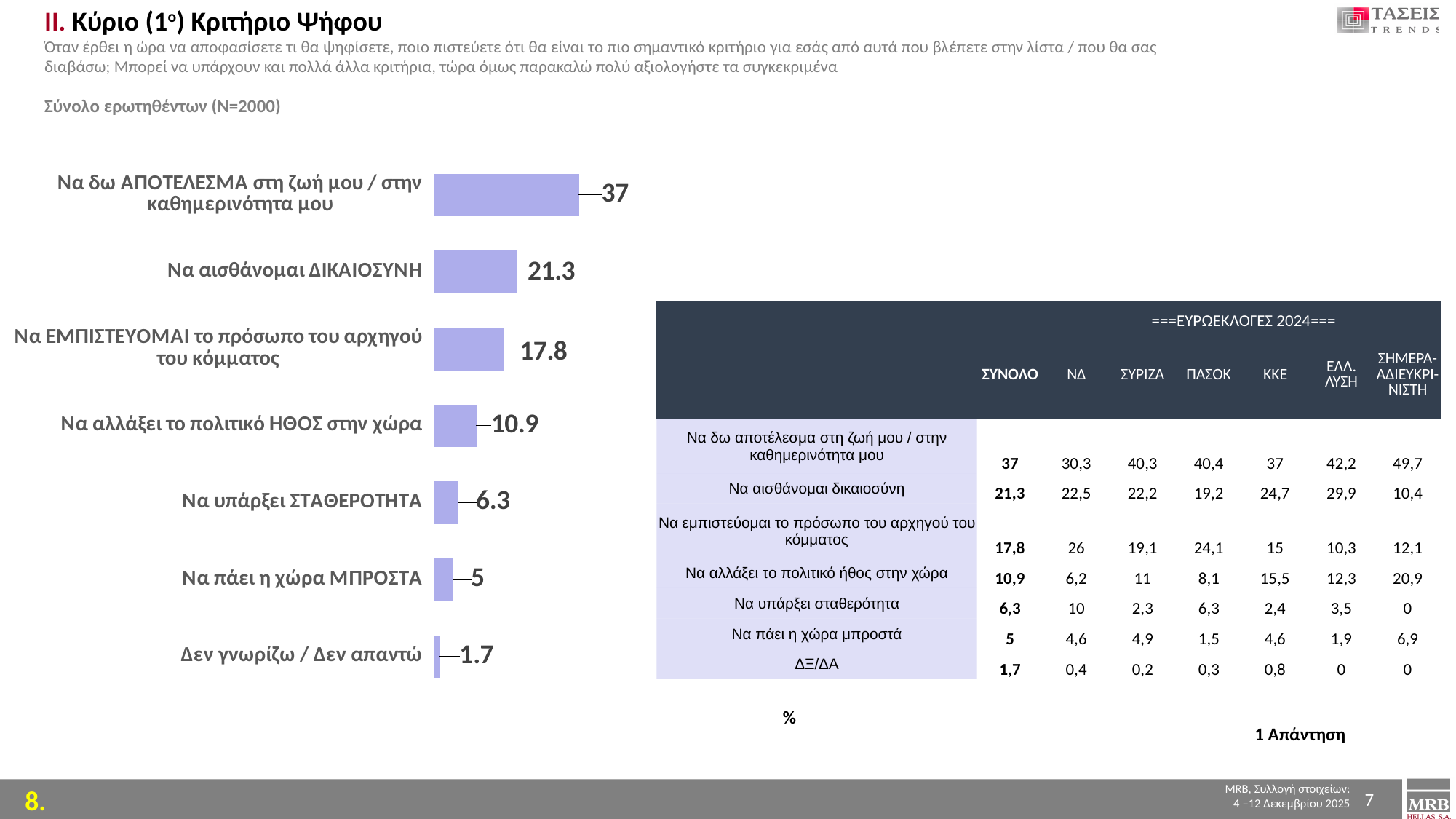
How many categories are shown in the bar chart? 7 What is the value for "Να δω ΑΠΟΤΕΛΕΣΜΑ στη ζωή μου / στην καθημερινότητα μου" in the bar chart? 37 Which category has the highest value in the bar chart? Να δω ΑΠΟΤΕΛΕΣΜΑ στη ζωή μου / στην καθημερινότητα μου What is the value for "Να αισθάνομαι ΔΙΚΑΙΟΣΥΝΗ" in the bar chart? 21.3 Which category has the lowest value in the bar chart? Δεν γνωρίζω / Δεν απαντώ What is the value for "Να ΕΜΠΙΣΤΕΥΟΜΑΙ το πρόσωπο του αρχηγού του κόμματος" in the bar chart? 17.8 What is the difference between the values for "Να αλλάξει το πολιτικό ΗΘΟΣ στην χώρα" and "Να πάει η χώρα ΜΠΡΟΣΤΑ" in the bar chart? 5.9 What is the sample size (N) stated on the slide for the respondents? N=2000 What is the difference between the values for "Να αισθάνομαι ΔΙΚΑΙΟΣΥΝΗ" and "Να ΕΜΠΙΣΤΕΥΟΜΑΙ το πρόσωπο του αρχηγού του κόμματος" in the bar chart? 3.5 What is the value for "Να υπάρξει ΣΤΑΘΕΡΟΤΗΤΑ" in the bar chart? 6.3 Which is larger in the bar chart: the value for "Να υπάρξει ΣΤΑΘΕΡΟΤΗΤΑ" or the value for "Να πάει η χώρα ΜΠΡΟΣΤΑ"? Να υπάρξει ΣΤΑΘΕΡΟΤΗΤΑ What kind of chart is shown on the slide? Bar chart